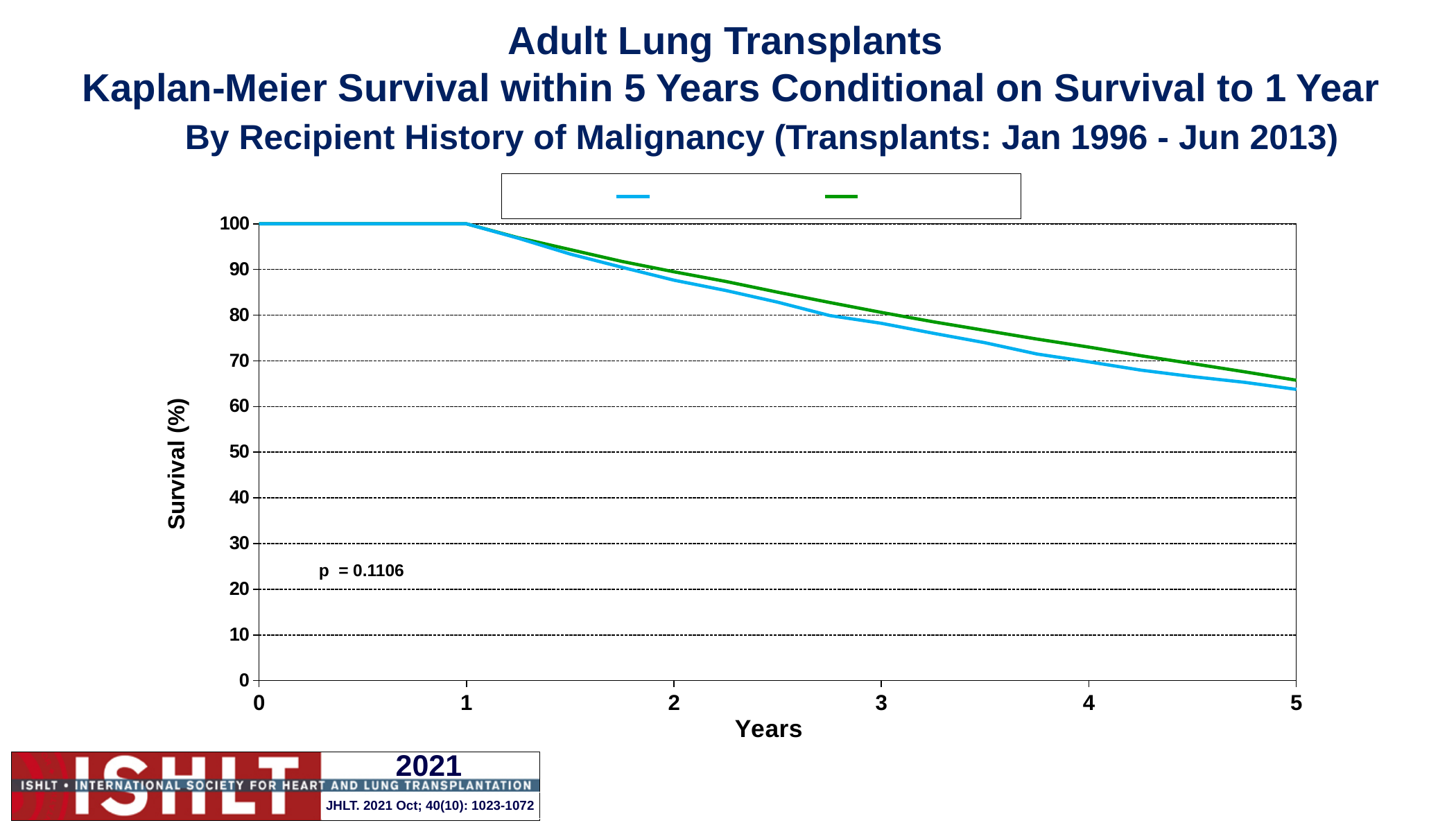
Is the value of the green line at year 4 greater or less than 70? greater What p-value is printed on the chart? p = 0.1106 Is the value of the green line at year 5 greater or less than 70? less What kind of chart is shown on the slide? line chart Is the value of the blue line at year 5 greater or less than 70? less What is the survival value of both lines at year 1? 100 Do the survival curves rise or fall as years increase from 1 to 5? fall At year 5, which line shows the higher survival, the blue line or the green line? green line What is the label of the y axis? Survival (%) At year 3, which line shows the lower survival, the blue line or the green line? blue line How many series (lines) are plotted on the chart? 2